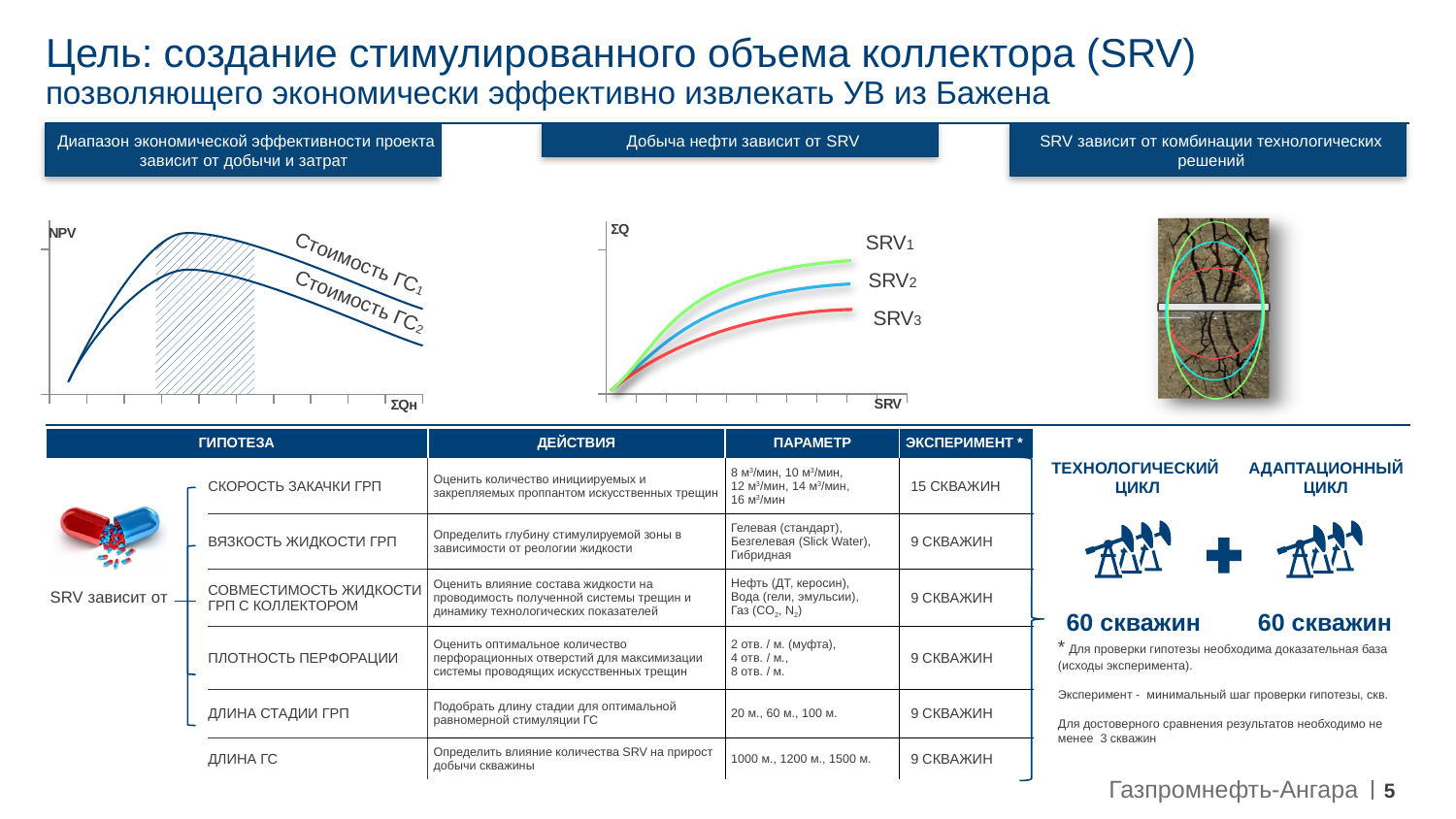
How many curves are plotted on the middle chart with the SRV axis? 3 On the left chart with the NPV axis, does NPV rise or fall along the x axis after reaching its peak? fall What is the label of the horizontal axis on the left chart with the NPV axis? ΣQн On the middle chart with the SRV axis, do the curves rise or fall as SRV increases? rise On the middle chart with the SRV axis, which curve is the highest? SRV1 What kind of chart is the middle chart with the SRV axis? line chart On the middle chart with the SRV axis, what colour is the SRV1 curve? green How many curves are plotted on the left chart with the NPV axis? 2 On the middle chart with the SRV axis, which curve lies higher, SRV2 or SRV3? SRV2 What kind of chart is the left chart with the NPV axis? line chart On the middle chart with the SRV axis, which curve is the lowest? SRV3 On the left chart with the NPV axis, which curve lies higher, Стоимость ГС1 or Стоимость ГС2? Стоимость ГС1